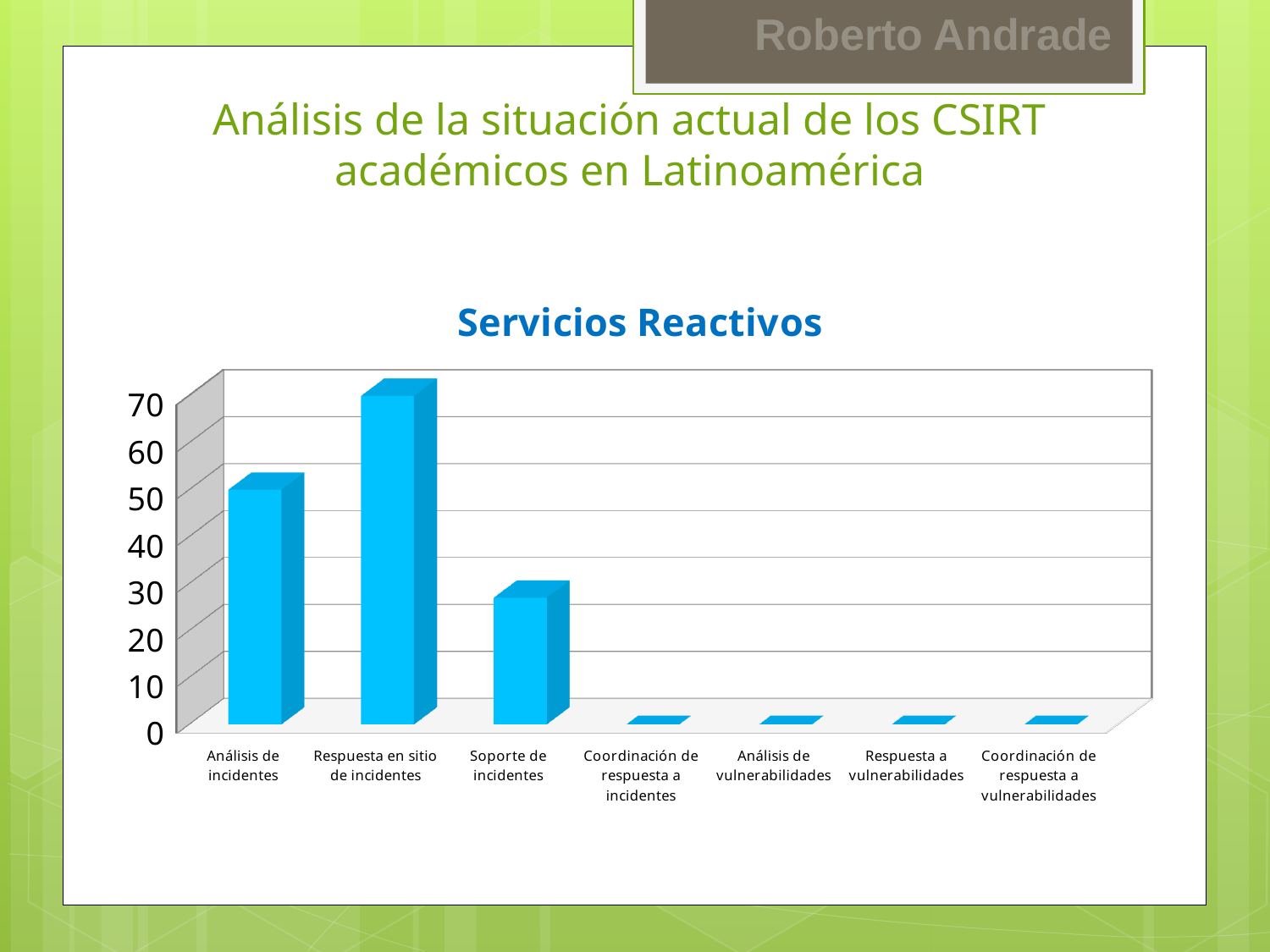
What kind of chart is shown on the slide? bar chart Which is larger, the value for Análisis de incidentes or the value for Soporte de incidentes? Análisis de incidentes How many categories in the chart have a clearly visible bar above zero? 3 Which category has the highest bar in the chart? Respuesta en sitio de incidentes Is the value for Soporte de incidentes greater or less than 40? less What is the title of the chart? Servicios Reactivos Is the value for Respuesta en sitio de incidentes greater or less than 60? greater What colour are the bars in the chart? blue Is the value for Coordinación de respuesta a incidentes greater or less than 10? less Which is larger, the value for Respuesta en sitio de incidentes or the value for Análisis de incidentes? Respuesta en sitio de incidentes How many categories are shown on the x axis of the chart? 7